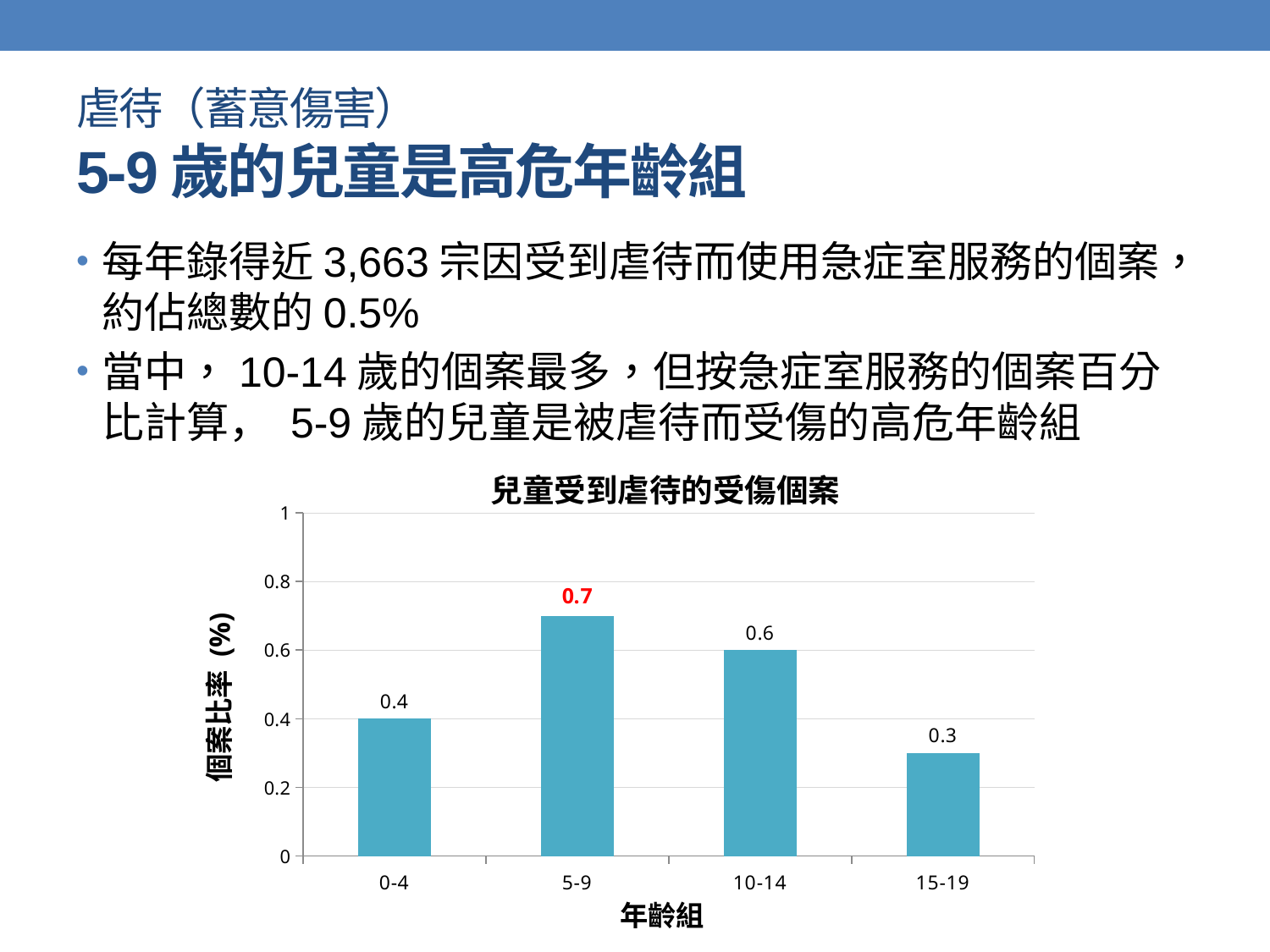
Which age group has the highest value? 5-9 Which age group has the lowest value? 15-19 Is the value for 10-14 greater or less than 0.4? greater What is the difference between the values for 5-9 and 10-14? 0.1 What kind of chart is shown on the slide? bar chart What is the value for the 15-19 age group? 0.3 What is the title of the chart? 兒童受到虐待的受傷個案 How many age groups are shown on the x axis? 4 What is the value for the 5-9 age group? 0.7 What is the difference between the values for 0-4 and 15-19? 0.1 What is the value for the 0-4 age group? 0.4 Which is larger, the value for 10-14 or the value for 0-4? 10-14